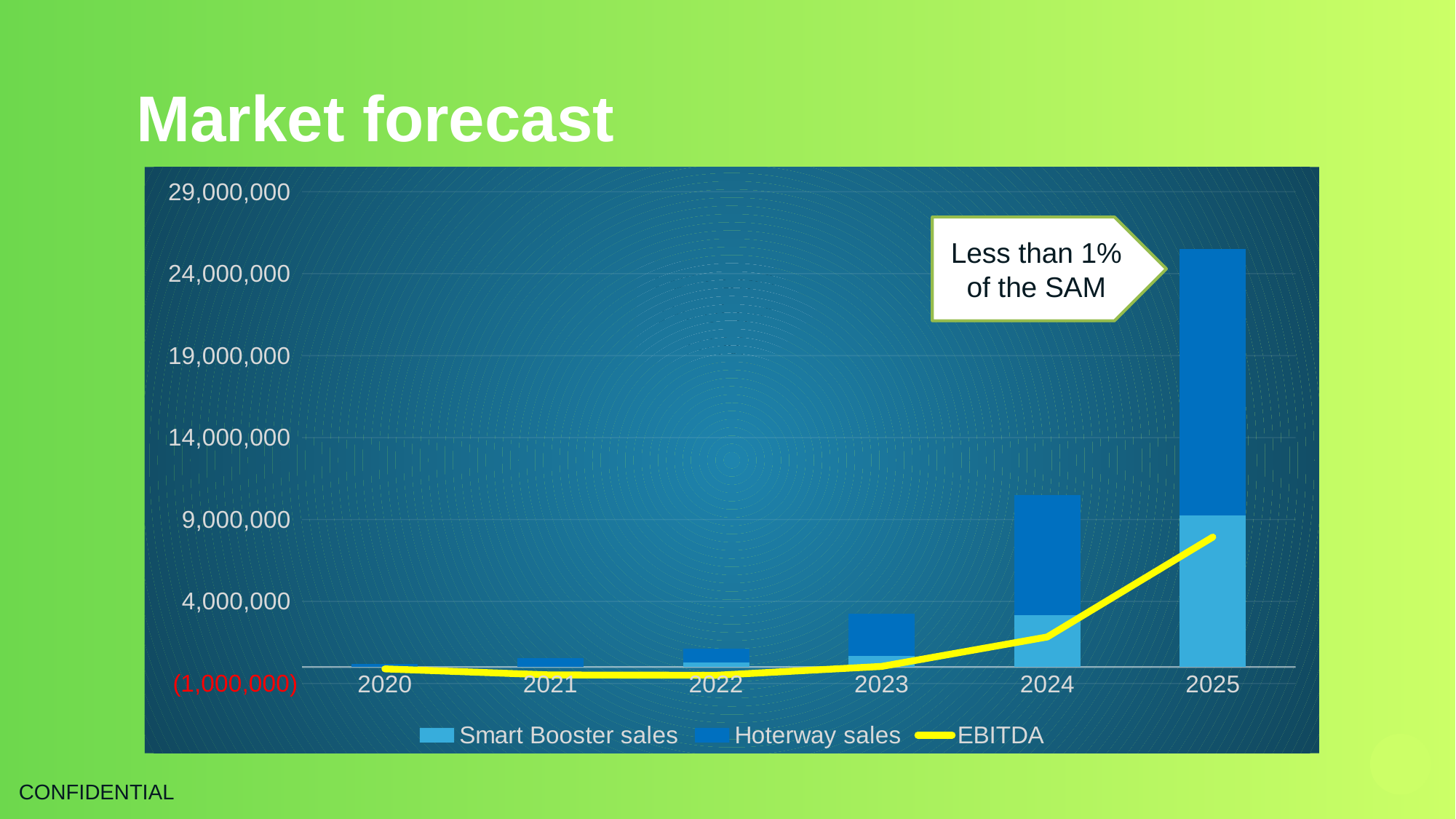
What kind of chart is shown on the slide? Stacked bar chart with a line How many series does the legend list? 3 Which year has the tallest stacked bar? 2025 Is the total stacked bar for 2024 greater or less than 9,000,000? greater Do the stacked bars rise or fall from 2020 to 2025? rise Which year has the smallest stacked bar? 2020 Is the total stacked bar for 2023 greater or less than 4,000,000? less What is the title of the chart on the slide? Market forecast What does the callout box on the chart say? Less than 1% of the SAM Is the total stacked bar for 2025 greater or less than 24,000,000? greater How many years are shown on the x axis? 6